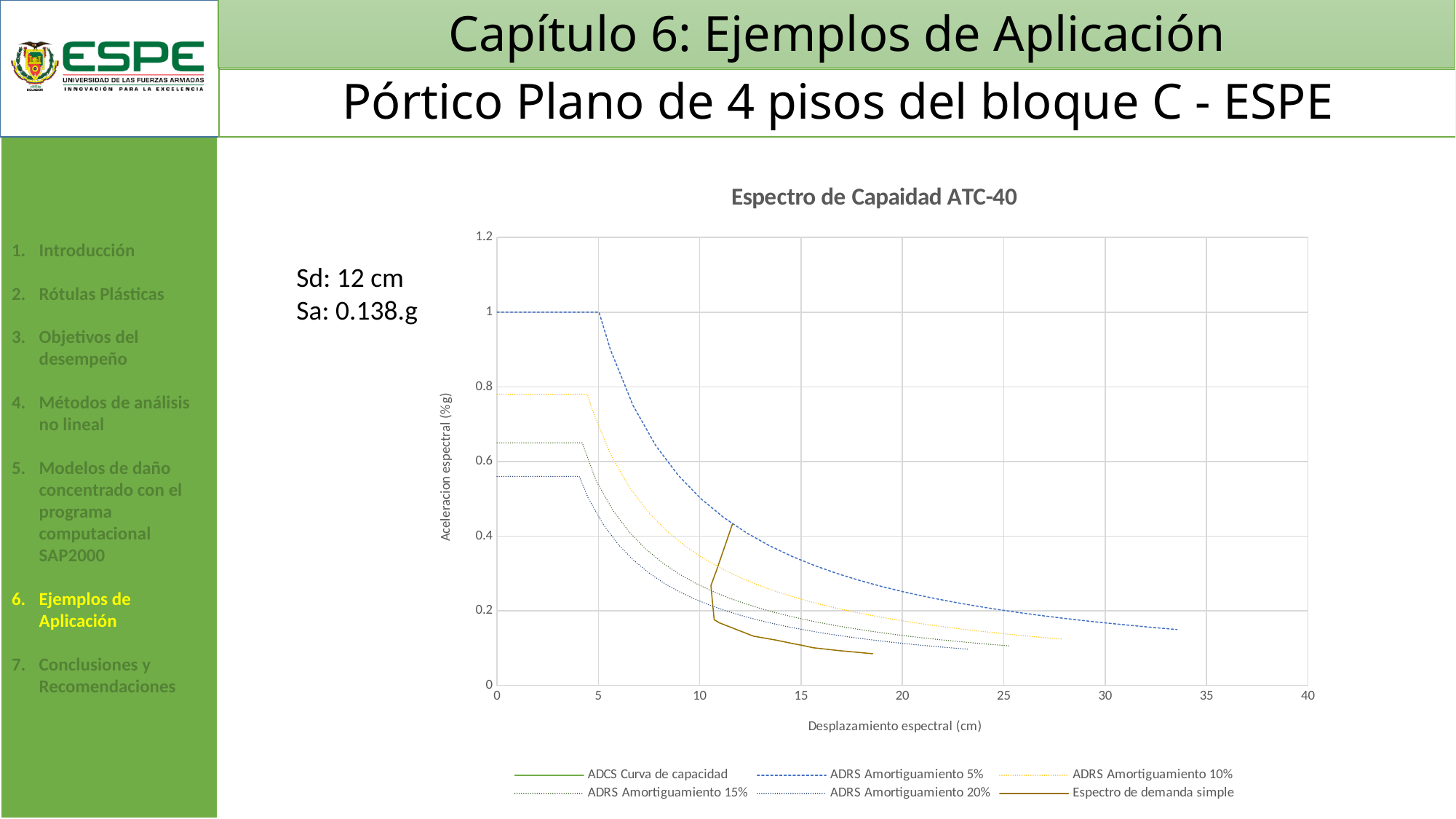
Which series extends furthest along the x axis of the chart? ADRS Amortiguamiento 5% What kind of chart is shown on the slide? line chart Is the initial flat value of the ADRS Amortiguamiento 5% series greater or less than 0.8? greater What is the title of the chart? Espectro de Capaidad ATC-40 How many series does the legend of the chart list? 6 Is the initial flat value of the ADRS Amortiguamiento 10% series greater or less than 1? less What is the label of the x axis of the chart? Desplazamiento espectral (cm) Is the initial flat value of the ADRS Amortiguamiento 20% series greater or less than 0.8? less Does the ADRS Amortiguamiento 5% series rise or fall as spectral displacement increases beyond 5 cm? fall Which series reaches the highest spectral acceleration on the chart? ADRS Amortiguamiento 5% At a spectral displacement of 10 cm, which series has the higher value: ADRS Amortiguamiento 5% or ADRS Amortiguamiento 20%? ADRS Amortiguamiento 5%